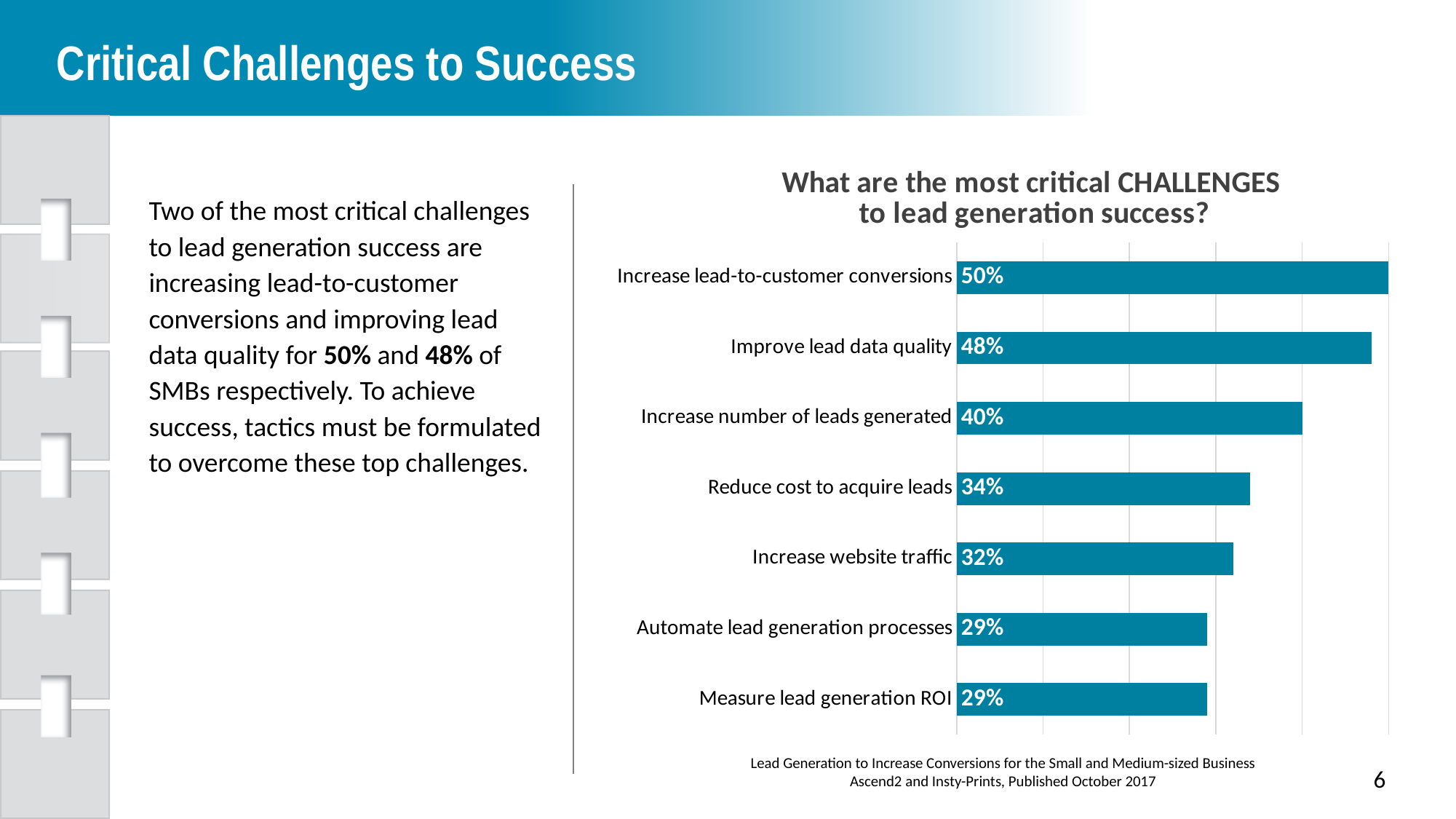
How many challenges are listed in the chart? 7 What is the difference between the values for 'Increase lead-to-customer conversions' and 'Measure lead generation ROI'? 21% What is the value shown for 'Increase website traffic'? 32% What percentage of SMBs cite 'Increase lead-to-customer conversions' as a critical challenge? 50% What is the value shown for 'Reduce cost to acquire leads'? 34% What type of chart is shown on the slide? Bar chart Which has a larger value: 'Reduce cost to acquire leads' or 'Automate lead generation processes'? Reduce cost to acquire leads What is the lowest value shown in the chart? 29% Which two challenges share the same value of 29%? Automate lead generation processes and Measure lead generation ROI Which challenge has the highest percentage in the chart? Increase lead-to-customer conversions What is the title of the chart? What are the most critical CHALLENGES to lead generation success? What is the difference between the values for 'Improve lead data quality' and 'Increase number of leads generated'? 8%